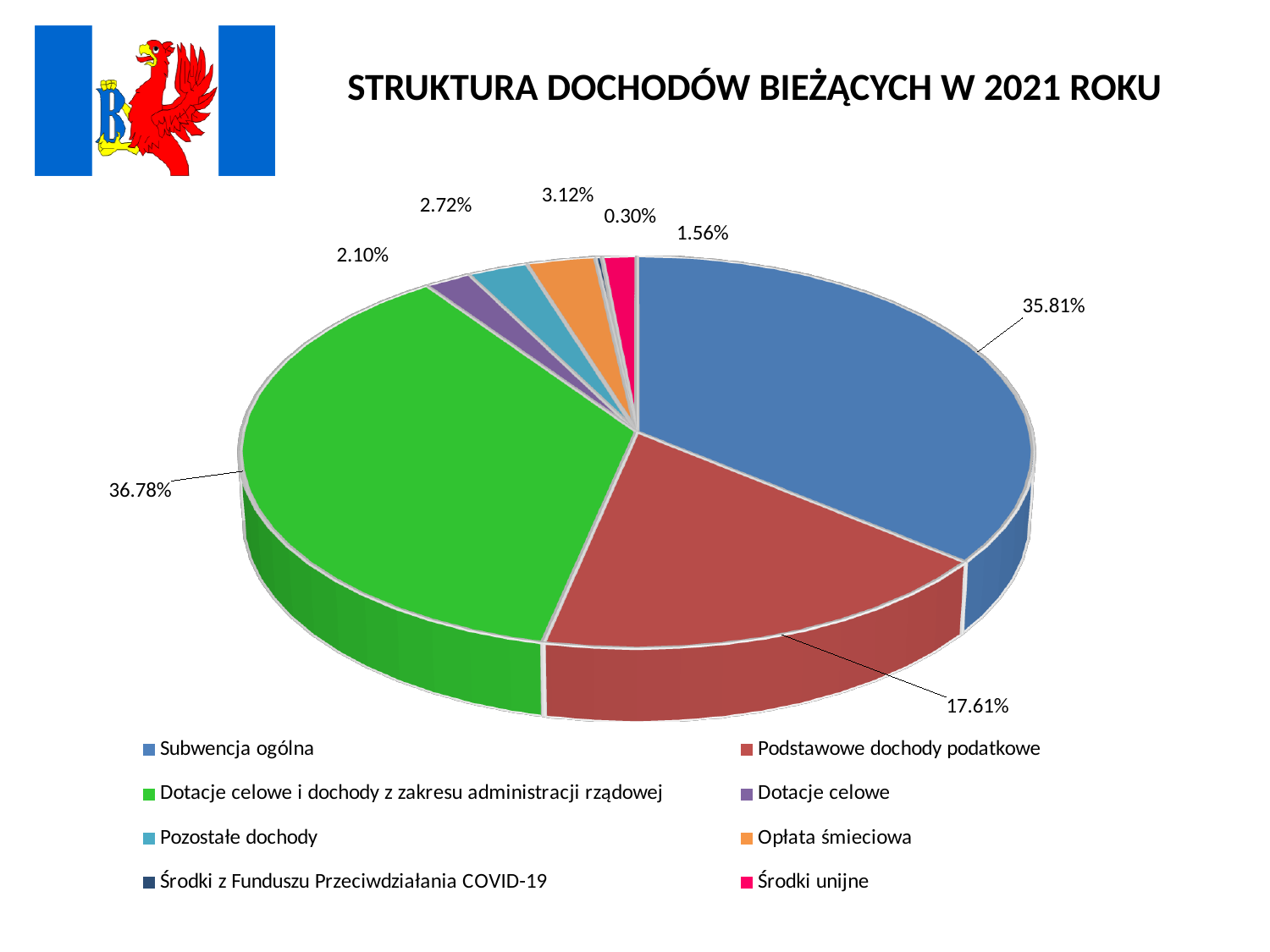
What is the difference between the shares of Subwencja ogólna and Podstawowe dochody podatkowe? 18.20% What type of chart is shown on the slide? pie chart What share of the pie is Opłata śmieciowa? 3.12% How many categories does the legend list? 8 Which category has the smallest share of the pie? Środki z Funduszu Przeciwdziałania COVID-19 What share of the pie is Podstawowe dochody podatkowe? 17.61% Which category has the largest share of the pie? Dotacje celowe i dochody z zakresu administracji rządowej What share of the pie is Subwencja ogólna? 35.81% What is the title of the chart? STRUKTURA DOCHODÓW BIEŻĄCYCH W 2021 ROKU Which is larger, the share of Pozostałe dochody or the share of Dotacje celowe? Pozostałe dochody